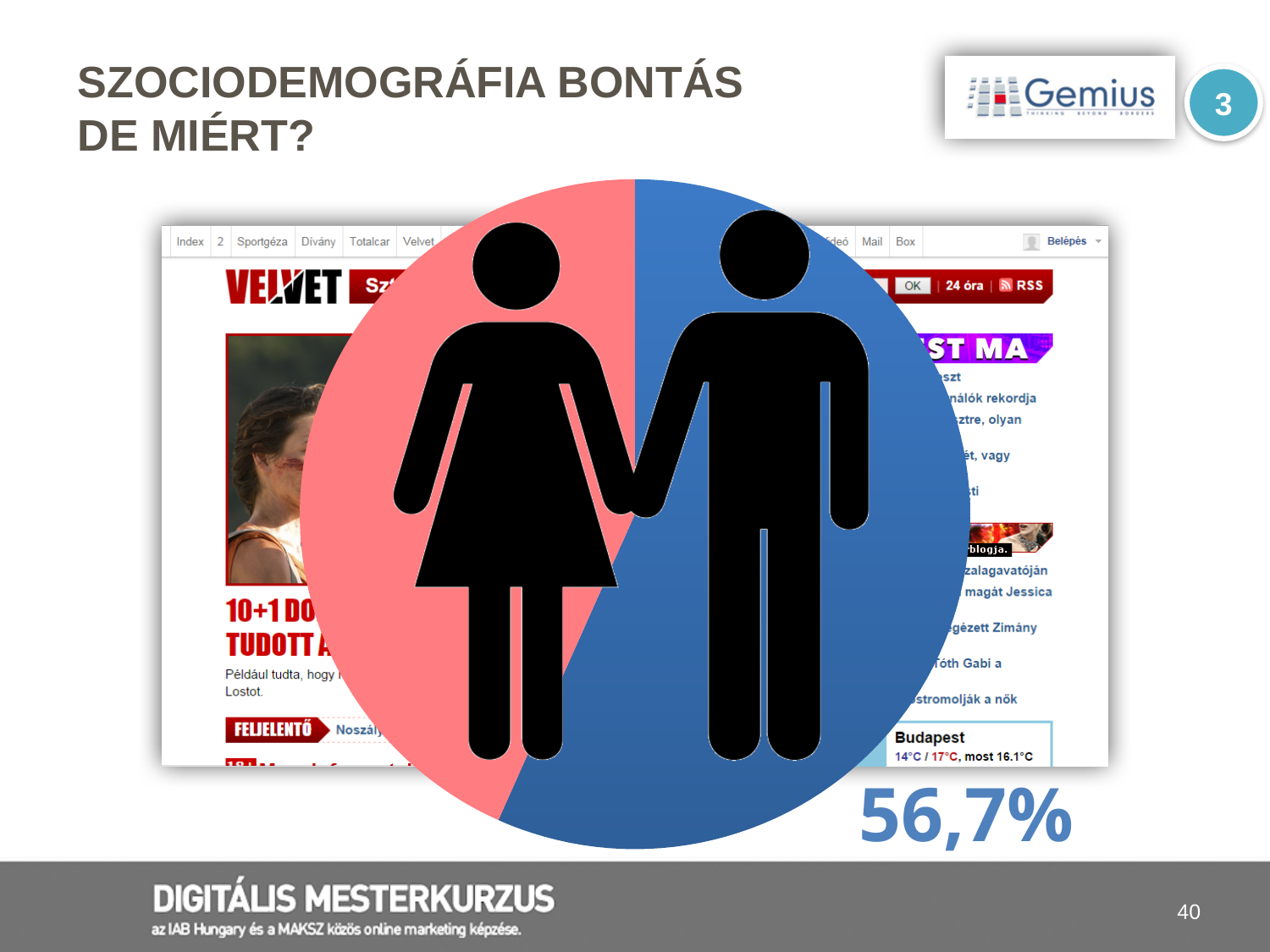
Which two colours are used for the slices of the pie chart? pink and blue Which slice of the pie chart is the smallest? the pink slice Which slice of the pie chart is larger, the blue one or the pink one? blue What share of the pie does the pink slice represent, given the blue slice is 56,7%? 43,3% Is the share of the blue slice greater or less than 50%? greater What icons are drawn over the pink and blue slices of the pie chart? a female figure and a male figure What kind of chart is shown on the slide? pie chart How many slices does the pie chart have? 2 What percentage is printed next to the blue slice of the pie chart? 56,7%